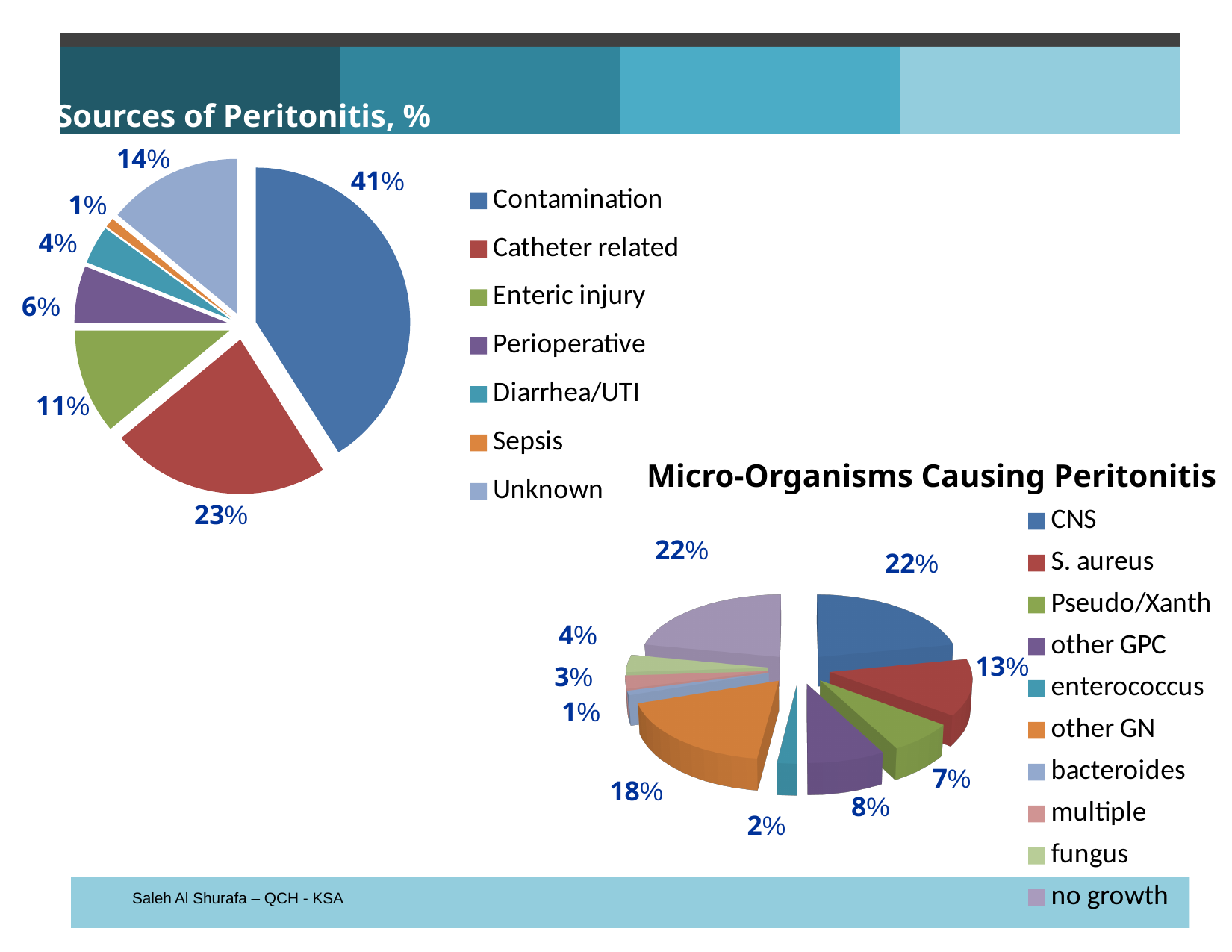
In the 'Sources of Peritonitis, %' chart, what percentage is attributed to Contamination? 41% In the 'Micro-Organisms Causing Peritonitis' chart, which micro-organism has the smallest share? bacteroides What type of chart is 'Sources of Peritonitis, %'? Pie chart In the 'Sources of Peritonitis, %' chart, which source has the largest share? Contamination In the 'Sources of Peritonitis, %' chart, what is the difference between the Contamination and Catheter related shares? 18% In the 'Micro-Organisms Causing Peritonitis' chart, which is larger: other GPC or Pseudo/Xanth? other GPC In the 'Micro-Organisms Causing Peritonitis' chart, how many categories does the legend list? 10 In the 'Sources of Peritonitis, %' chart, which source has the smallest share? Sepsis In the 'Sources of Peritonitis, %' chart, what percentage is Catheter related? 23% In the 'Micro-Organisms Causing Peritonitis' chart, what percentage is attributed to other GN? 18% In the 'Sources of Peritonitis, %' chart, how many categories does the legend list? 7 In the 'Micro-Organisms Causing Peritonitis' chart, what percentage is attributed to S. aureus? 13%